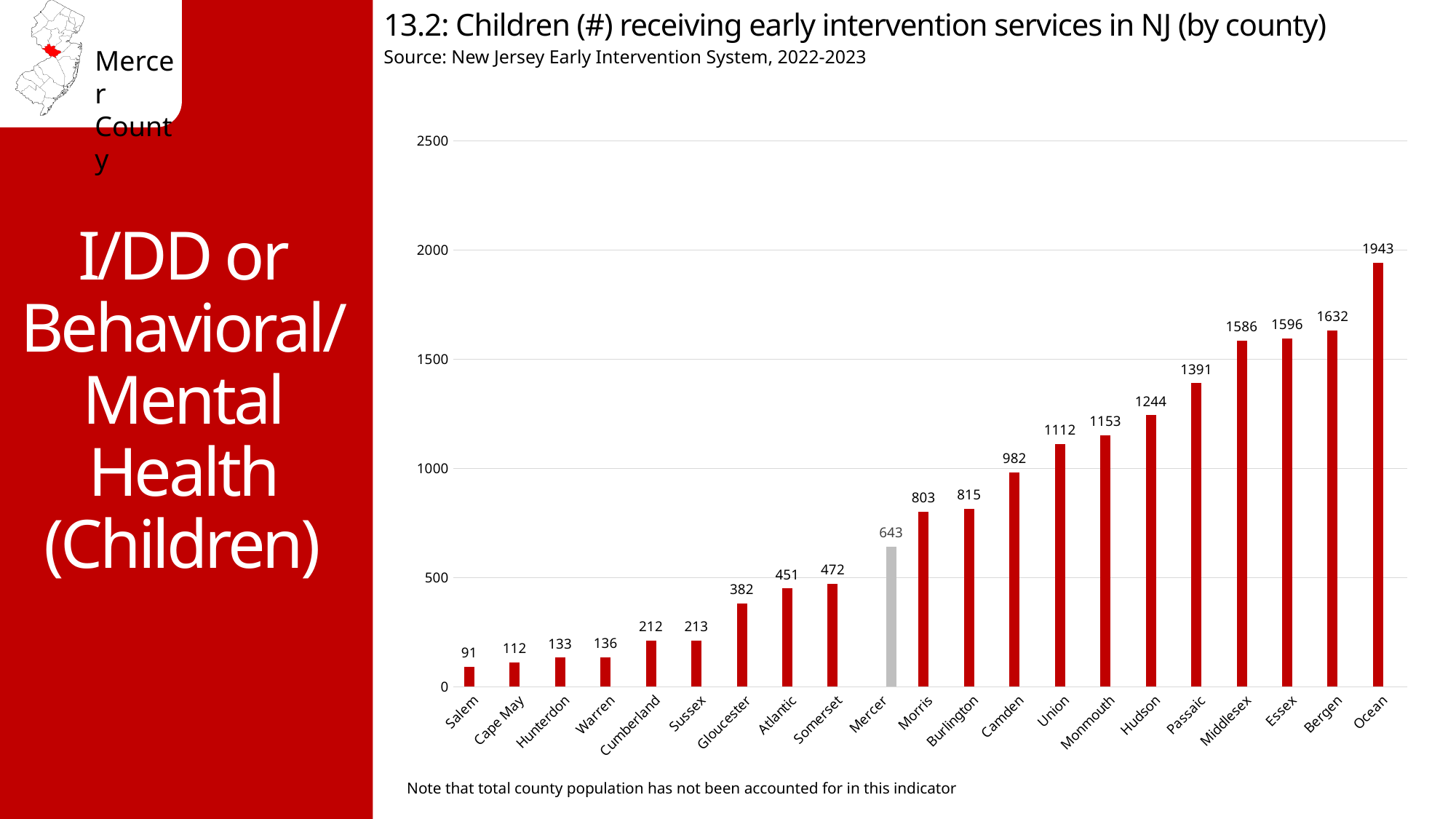
How many counties are shown on the chart? 21 Which county has a larger value, Camden or Morris? Camden How many children are receiving early intervention services in Mercer County? 643 Do the values rise or fall moving from left to right along the x axis? Rise What is the value shown for Gloucester County? 382 Which county has the lowest number of children receiving early intervention services? Salem What is the value shown for Ocean County? 1943 Which county's bar is coloured grey instead of red? Mercer Which county has the highest number of children receiving early intervention services? Ocean What kind of chart is shown on the slide? Bar chart What is the difference between the values for Bergen and Mercer? 989 Is the value for Hudson greater or less than 1000? greater